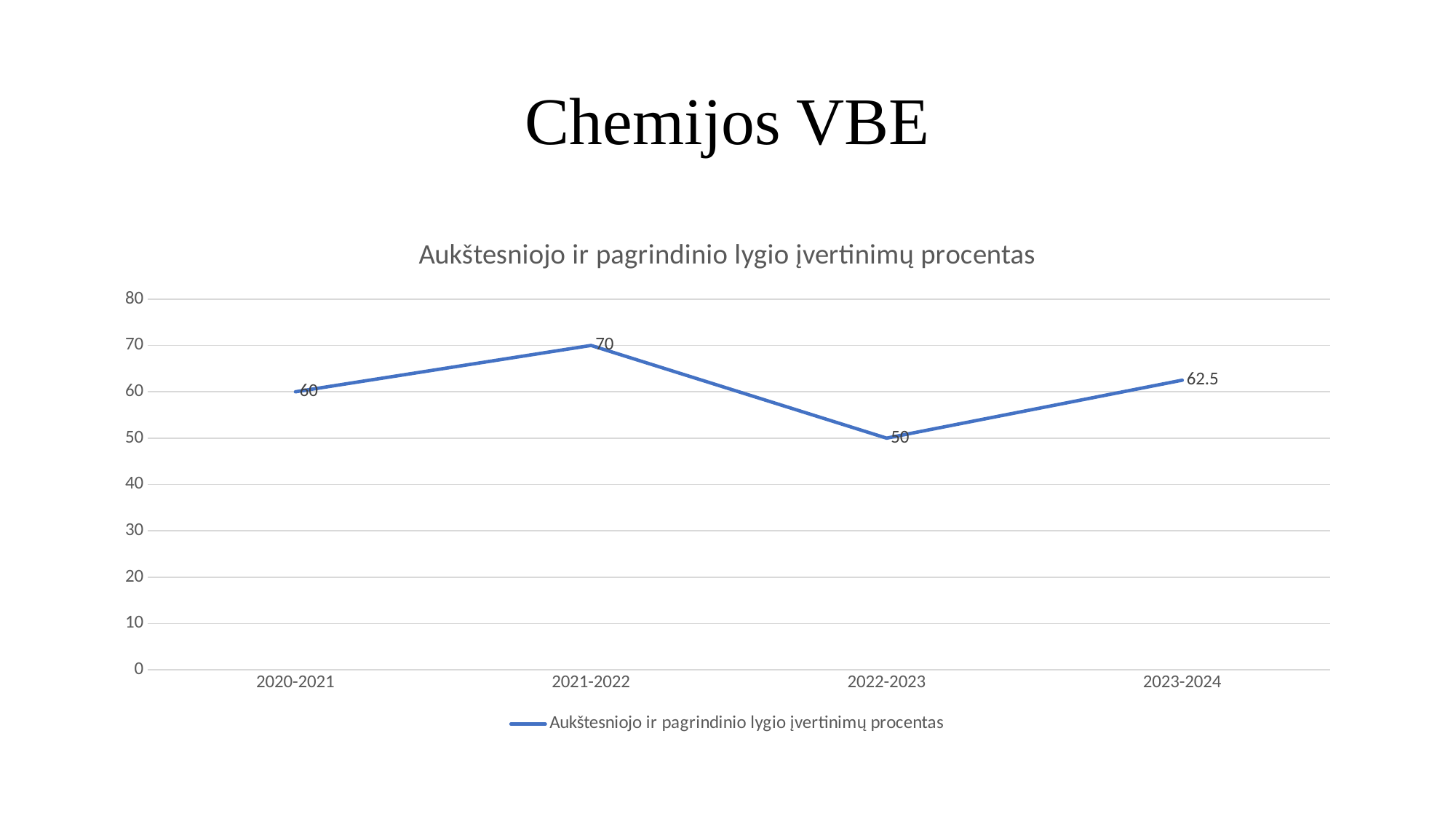
What is the value for 2023-2024? 62.5 How many school years are plotted on the chart? 4 What kind of chart is shown on the slide? line chart What is the value for 2022-2023? 50 What is the value for 2021-2022? 70 Is the value for 2022-2023 greater or less than 60? less What is the value for 2020-2021? 60 Which school year has the lowest value? 2022-2023 Which school year has the highest value? 2021-2022 What is the difference between the values for 2021-2022 and 2022-2023? 20 What is the title of the chart? Aukštesniojo ir pagrindinio lygio įvertinimų procentas Which is larger, the value for 2020-2021 or the value for 2023-2024? 2023-2024